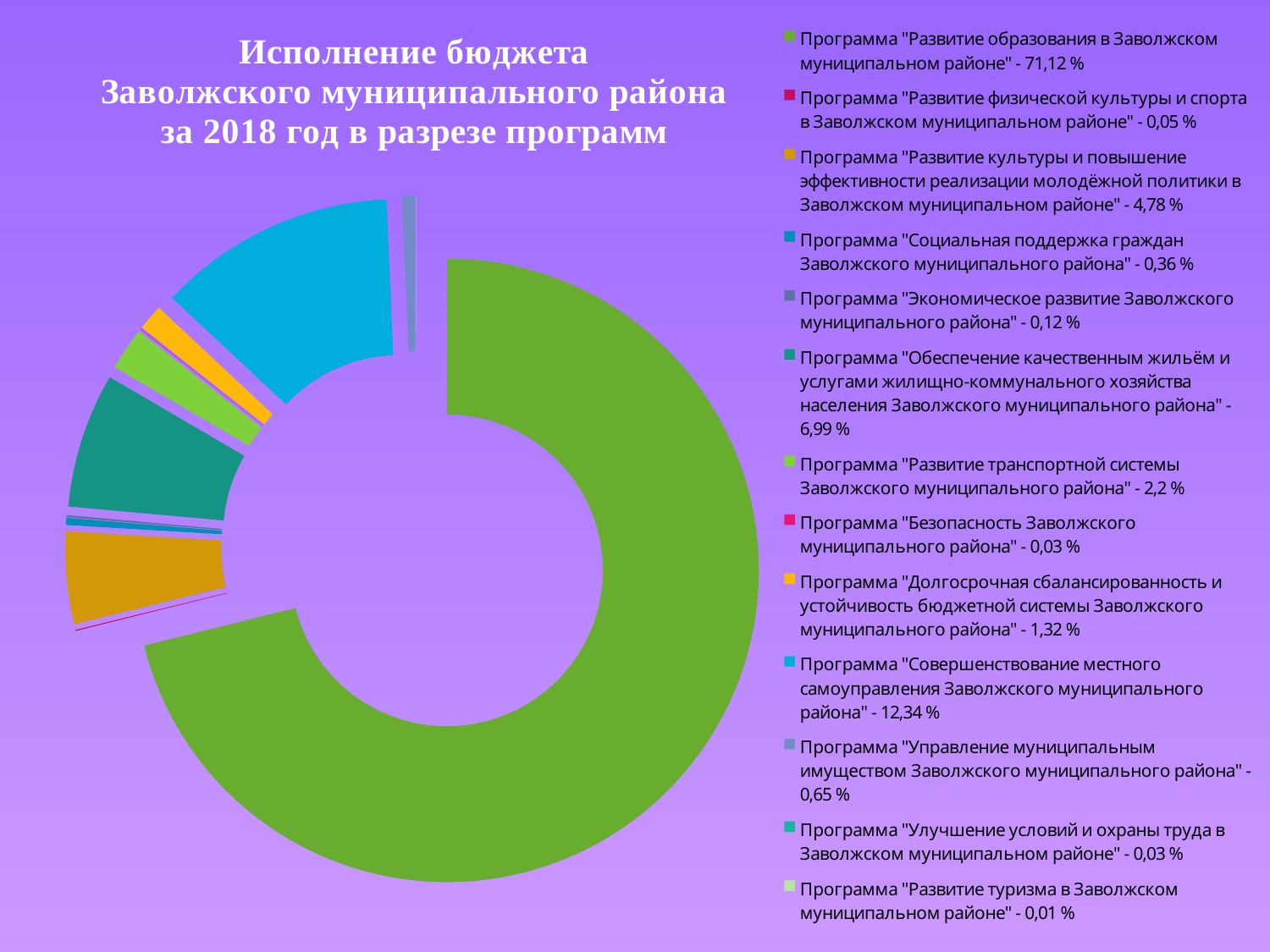
Which has the larger share: the programme "Развитие культуры и повышение эффективности реализации молодёжной политики" or the programme "Обеспечение качественным жильём и услугами жилищно-коммунального хозяйства"? Программа "Обеспечение качественным жильём и услугами жилищно-коммунального хозяйства населения Заволжского муниципального района" What share is shown for the programme "Развитие транспортной системы Заволжского муниципального района"? 2,2 % By how many percentage points does the share of "Развитие образования" exceed the share of "Совершенствование местного самоуправления"? 58,78 What share is shown for the programme "Обеспечение качественным жильём и услугами жилищно-коммунального хозяйства населения Заволжского муниципального района"? 6,99 % What share of the budget does the programme "Развитие образования в Заволжском муниципальном районе" account for? 71,12 % What colour is the segment for the programme "Развитие образования в Заволжском муниципальном районе"? Green Which programme has the largest share of the budget? Программа "Развитие образования в Заволжском муниципальном районе" Which programme has the smallest share of the budget? Программа "Развитие туризма в Заволжском муниципальном районе" What share is shown for the programme "Совершенствование местного самоуправления Заволжского муниципального района"? 12,34 % How many programmes (categories) does the legend list? 13 What is the title of the chart? Исполнение бюджета Заволжского муниципального района за 2018 год в разрезе программ What kind of chart is shown on the slide? Doughnut (pie) chart